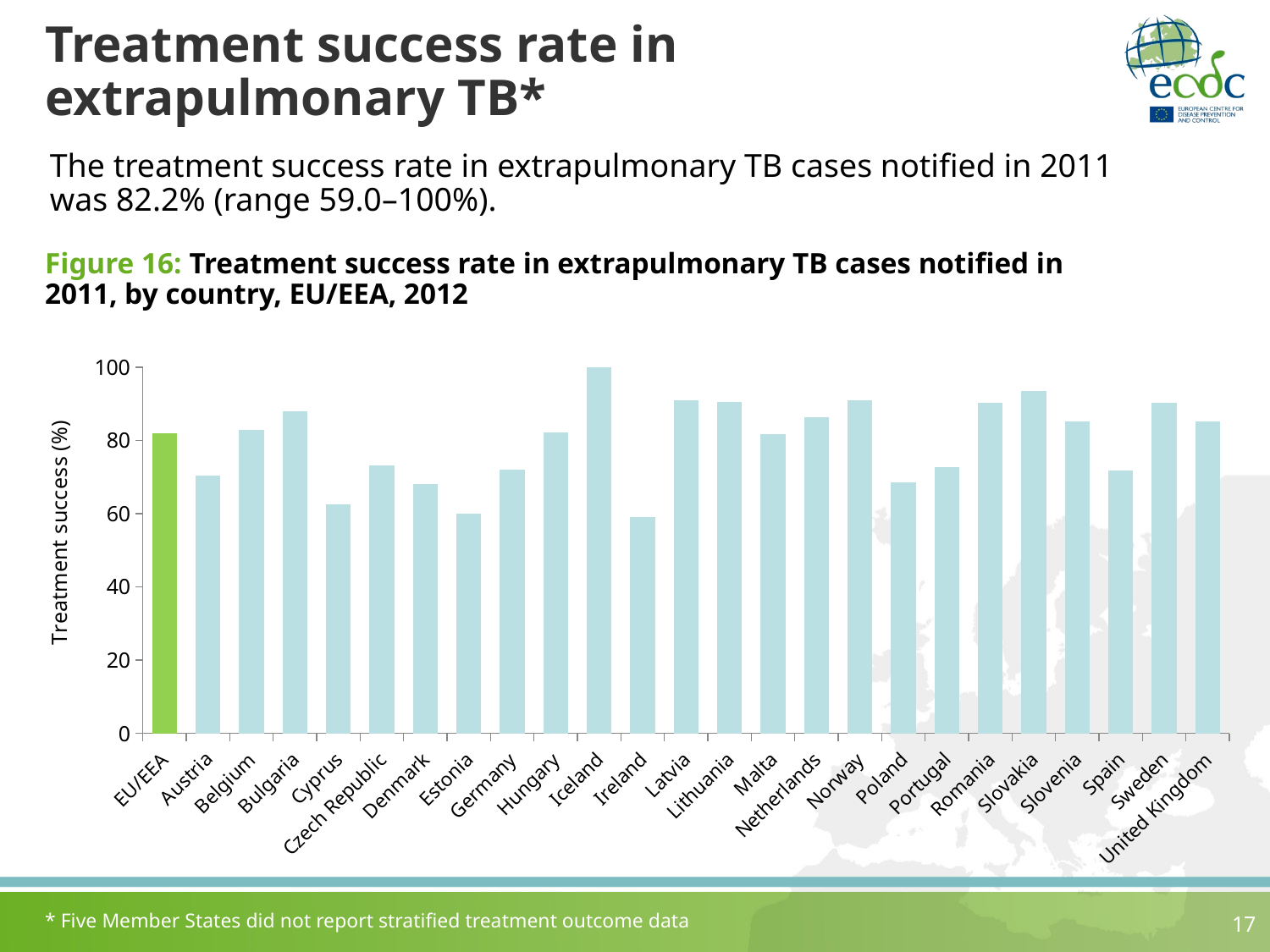
Which has a higher treatment success rate, Slovakia or Spain? Slovakia What kind of chart is shown in Figure 16? bar chart Which bar in the chart is coloured green rather than light blue? EU/EEA Which country has the highest treatment success rate in the chart? Iceland What is the treatment success rate for EU/EEA, as stated on the slide? 82.2% Is the treatment success rate for Bulgaria greater or less than 80? greater Is the treatment success rate for Cyprus greater or less than 80? less Which has a higher treatment success rate, Bulgaria or Austria? Bulgaria Is the treatment success rate for Poland greater or less than 80? less What is the treatment success rate for Iceland in the chart? 100 How many countries/categories are shown on the x axis of the chart? 25